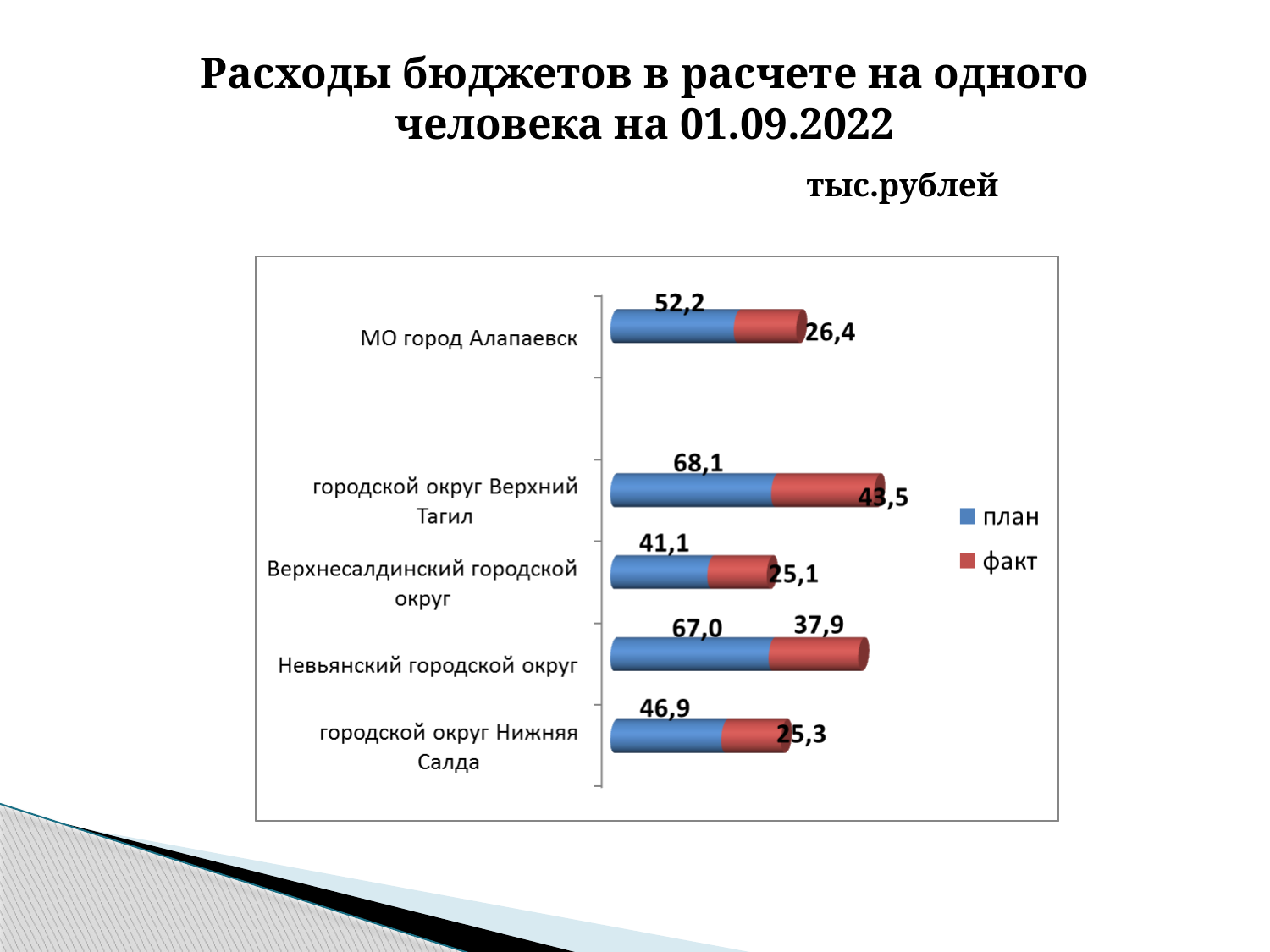
What is the план value for МО город Алапаевск? 52,2 Which category has the highest план value? городской округ Верхний Тагил What kind of chart is shown on the slide? bar chart How many series does the legend list? 2 Which category has the lowest факт value? Верхнесалдинский городской округ What is the факт value for городской округ Верхний Тагил? 43,5 How many categories are shown in the chart? 5 What is the difference between the план and факт values for Верхнесалдинский городской округ? 16,0 Which is larger: the факт value for МО город Алапаевск or the факт value for городской округ Нижняя Салда? МО город Алапаевск Which colour represents the факт series in the chart? red What is the план value for городской округ Нижняя Салда? 46,9 What is the факт value for Невьянский городской округ? 37,9